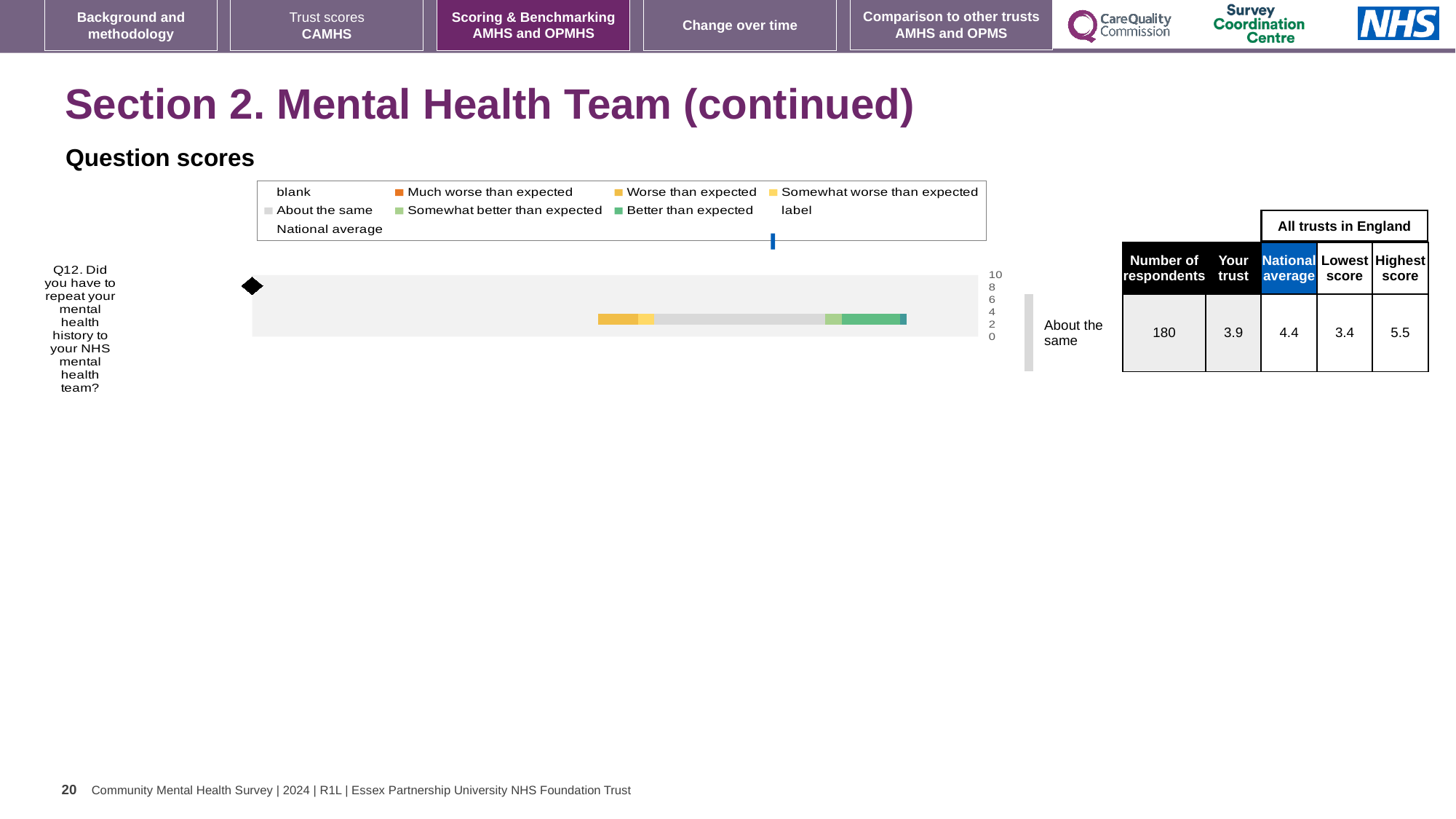
What is the difference between the highest score and the lowest score for Q12? 2.1 What is the highest score among all trusts in England for Q12? 5.5 What is the highest value shown on the chart's axis? 10 What is the 'Your trust' score for Q12? 3.9 How many survey questions are plotted in the question scores chart? 1 What kind of chart is used to show the question scores on this slide? bar chart Which is larger for Q12, the trust's score or the national average? national average What is the national average score for Q12? 4.4 Which question is plotted in the question scores chart? Q12. Did you have to repeat your mental health history to your NHS mental health team? How many respondents answered Q12? 180 What is the lowest score among all trusts in England for Q12? 3.4 What benchmark category is shown next to the bar for Q12? About the same